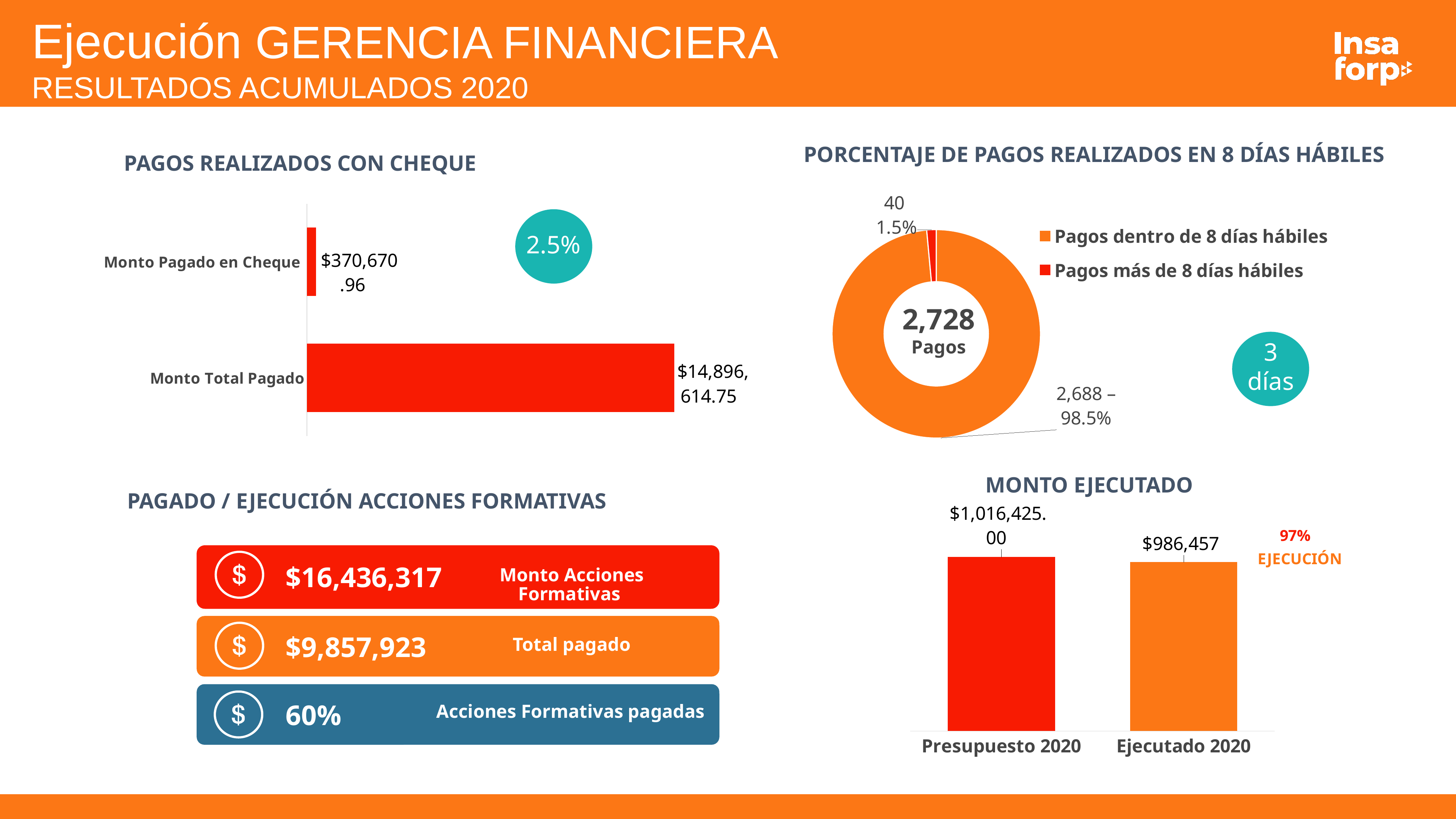
In the 'PORCENTAJE DE PAGOS REALIZADOS EN 8 DÍAS HÁBILES' chart, how many payments took more than 8 business days? 40 In the 'PAGOS REALIZADOS CON CHEQUE' chart, what is the value for Monto Pagado en Cheque? $370,670.96 In the 'PAGOS REALIZADOS CON CHEQUE' chart, what is the difference between Monto Total Pagado and Monto Pagado en Cheque? $14,525,943.79 In the 'PAGOS REALIZADOS CON CHEQUE' chart, what is the value for Monto Total Pagado? $14,896,614.75 In the 'MONTO EJECUTADO' chart, what is the value for Ejecutado 2020? $986,457 How many entries does the legend of the 'PORCENTAJE DE PAGOS REALIZADOS EN 8 DÍAS HÁBILES' chart list? 2 In the 'PORCENTAJE DE PAGOS REALIZADOS EN 8 DÍAS HÁBILES' chart, what is the total number of payments shown in the centre? 2,728 In the 'PORCENTAJE DE PAGOS REALIZADOS EN 8 DÍAS HÁBILES' chart, what share of payments were made within 8 business days? 98.5% In the 'MONTO EJECUTADO' chart, how many categories are shown on the x axis? 2 In the 'PAGOS REALIZADOS CON CHEQUE' chart, which category has the larger value? Monto Total Pagado What kind of chart is 'PAGOS REALIZADOS CON CHEQUE'? Bar chart In the 'MONTO EJECUTADO' chart, what is the value for Presupuesto 2020? $1,016,425.00